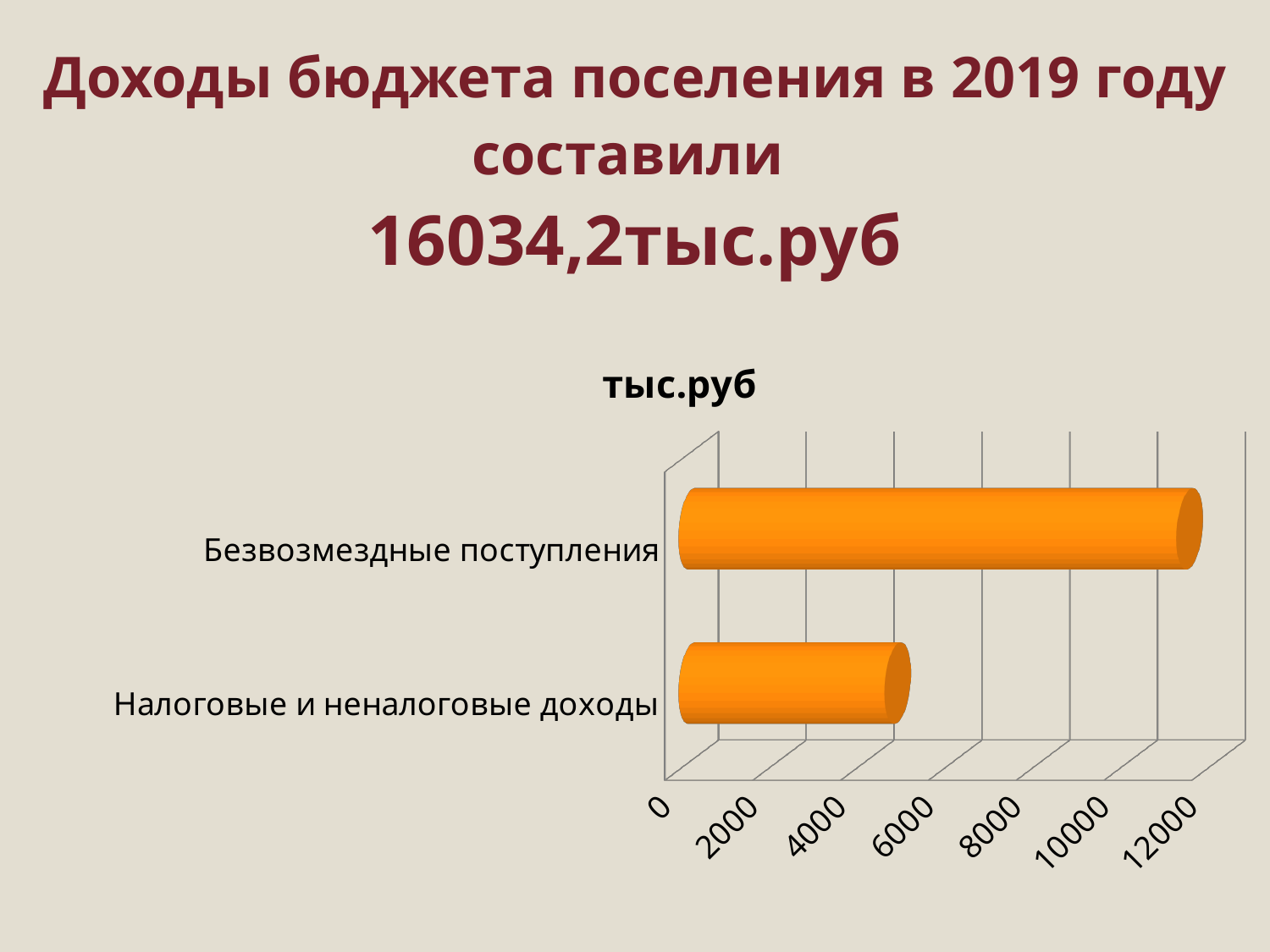
Which category has the highest value in the chart? Безвозмездные поступления Which category has the lowest value in the chart? Налоговые и неналоговые доходы Is the value for Налоговые и неналоговые доходы greater or less than 6000? less What is the highest tick value shown on the value axis of the chart? 12000 Which is larger: Безвозмездные поступления or Налоговые и неналоговые доходы? Безвозмездные поступления Is the value for Безвозмездные поступления greater or less than 10000? greater What is the title of the chart? тыс.руб What kind of chart is shown on the slide? bar chart How many categories are plotted in the chart? 2